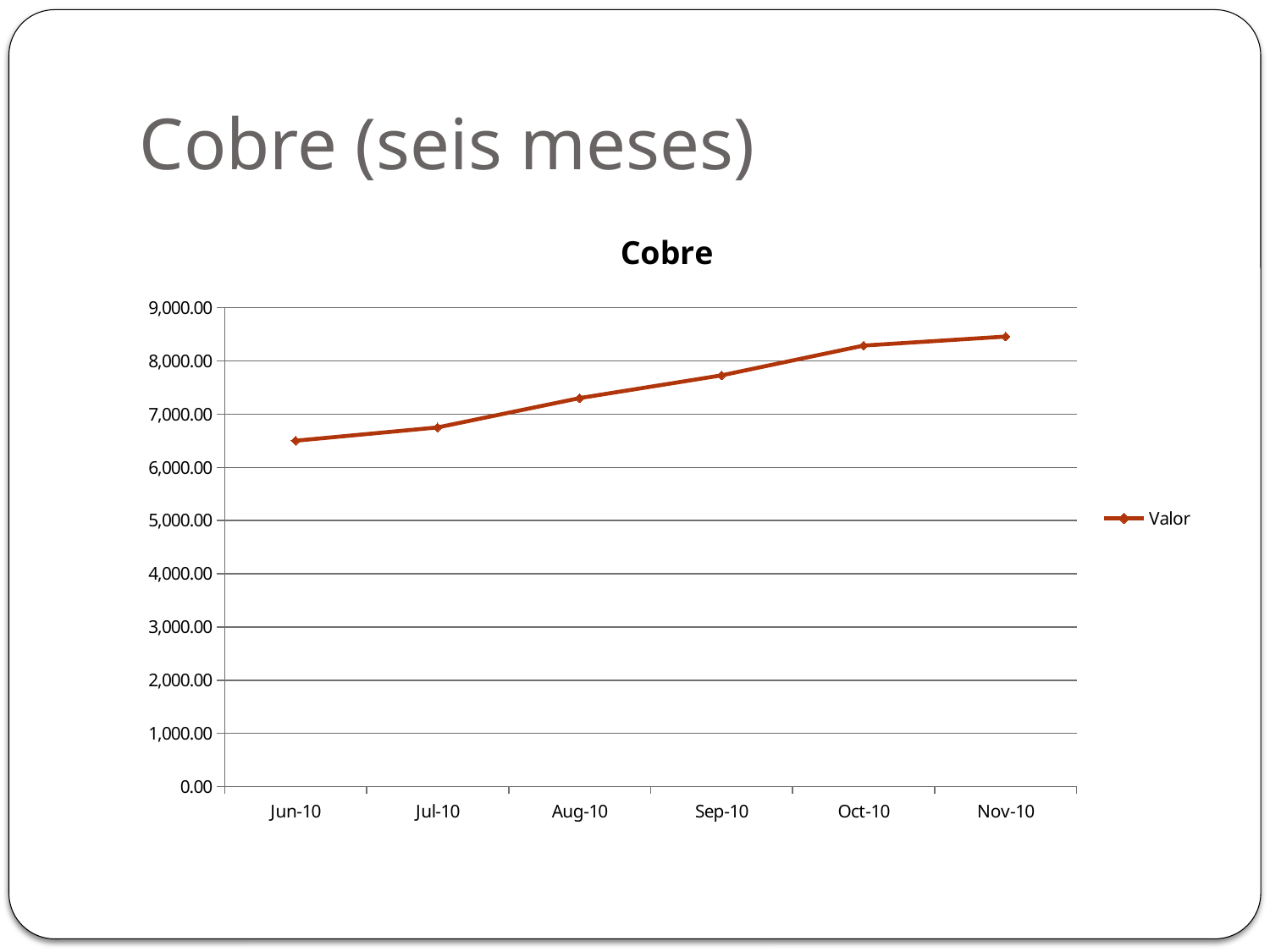
Which month has the highest value? Nov-10 How many months are plotted on the x axis? 6 Which is larger, the value for Oct-10 or the value for Jul-10? Oct-10 Is the value for Jun-10 greater or less than 7,000.00? less Is the value for Nov-10 greater or less than 8,000.00? greater Do the values rise or fall from Jun-10 to Nov-10? Rise What kind of chart is shown on the slide? Line chart Which month has the lowest value? Jun-10 What series name does the legend list? Valor How many series does the legend list? 1 Is the value for Sep-10 greater or less than 8,000.00? less What is the title of the chart? Cobre